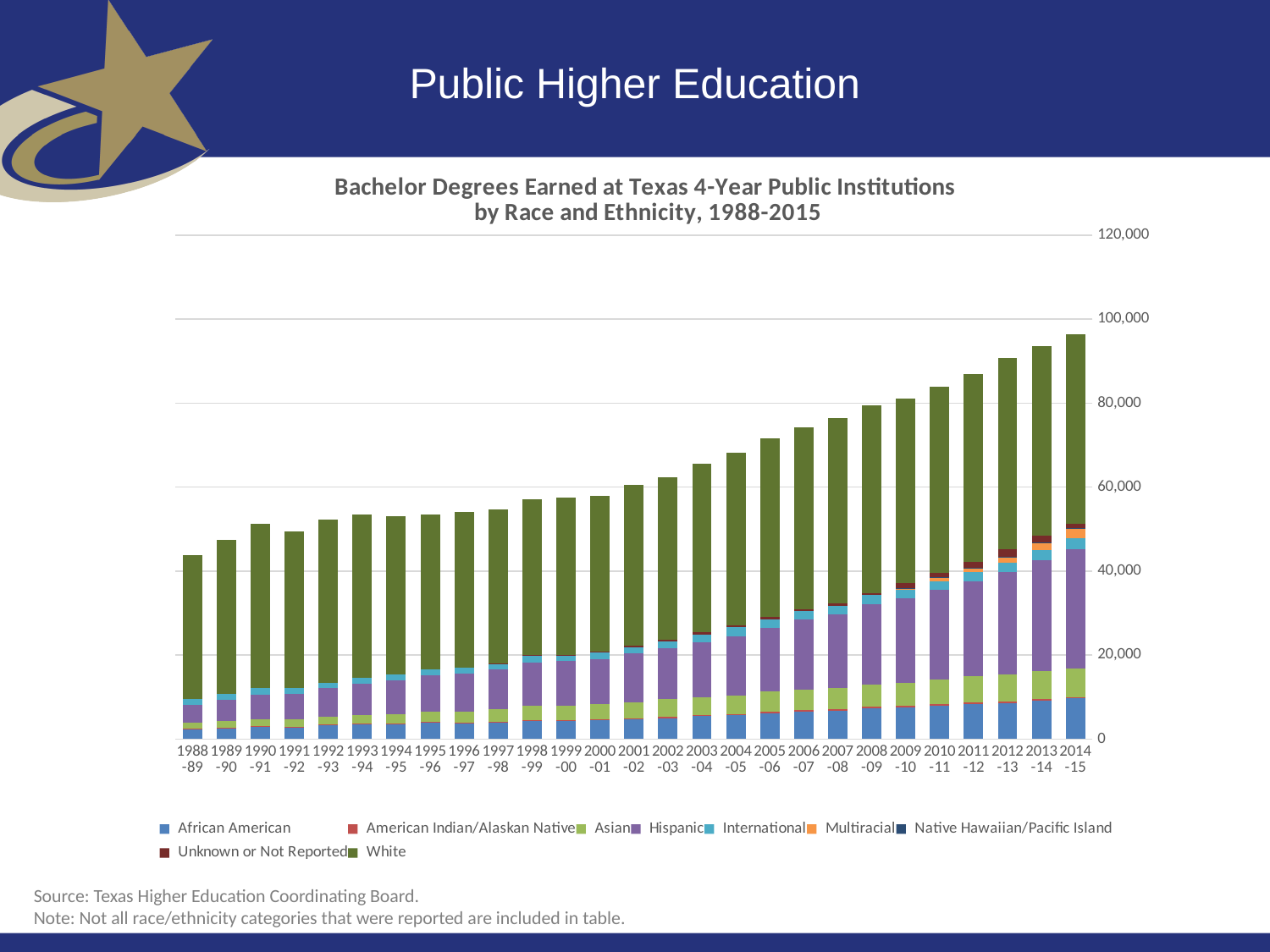
What is the title of the chart? Bachelor Degrees Earned at Texas 4-Year Public Institutions by Race and Ethnicity, 1988-2015 Do the total bachelor degrees generally rise or fall from 1988-89 to 2014-15? rise Which academic year has the lowest total number of bachelor degrees? 1988-89 Which total is larger, 2014-15 or 1988-89? 2014-15 How many academic years (bars) are shown on the x axis? 27 What kind of chart is shown on the slide? stacked bar chart Which academic year has the highest total number of bachelor degrees? 2014-15 Which series makes up the largest segment of each bar? White Is the total for 2005-06 greater or less than 60,000? greater Is the total for 2014-15 greater or less than 80,000? greater Is the total for 1988-89 greater or less than 60,000? less How many series does the legend list? 9